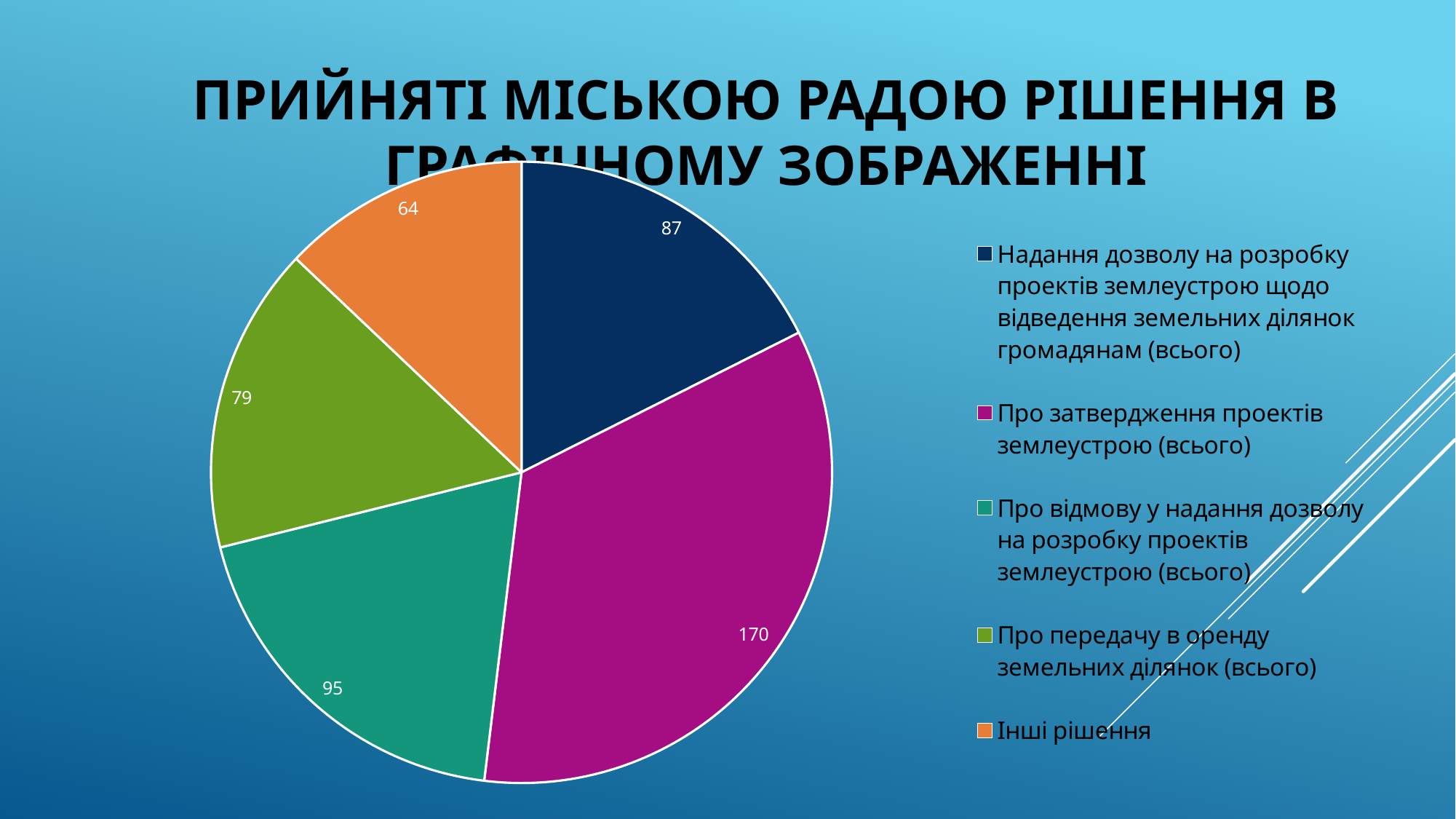
What is the value for "Про затвердження проектів землеустрою (всього)"? 170 How many slices does the pie chart have? 5 What is the value for "Про відмову у надання дозволу на розробку проектів землеустрою (всього)"? 95 What is the total of all slices in the pie chart? 495 What is the difference between the values for "Про затвердження проектів землеустрою (всього)" and "Надання дозволу на розробку проектів землеустрою щодо відведення земельних ділянок громадянам (всього)"? 83 What is the value for "Інші рішення"? 64 What colour is the slice for "Інші рішення"? orange What is the value for "Про передачу в оренду земельних ділянок (всього)"? 79 Which category has the largest slice? Про затвердження проектів землеустрою (всього) Which is larger: the value for "Про відмову у надання дозволу на розробку проектів землеустрою (всього)" or the value for "Надання дозволу на розробку проектів землеустрою щодо відведення земельних ділянок громадянам (всього)"? Про відмову у надання дозволу на розробку проектів землеустрою (всього) What kind of chart is shown on the slide? pie chart Which category has the smallest slice? Інші рішення